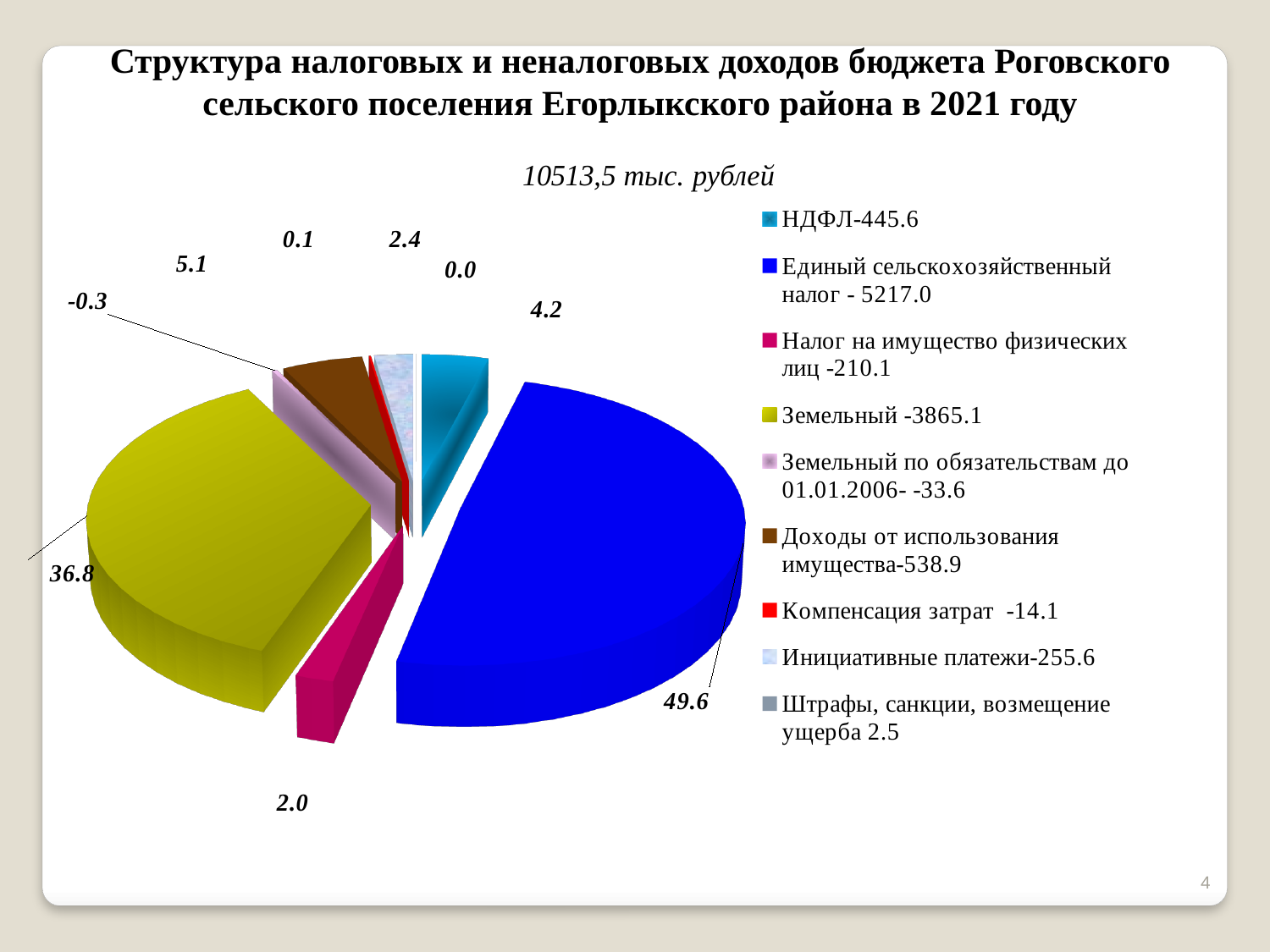
Which has the larger labelled share: НДФЛ or Доходы от использования имущества? Доходы от использования имущества Which category has the largest share of the pie? Единый сельскохозяйственный налог What kind of chart is shown on the slide? pie chart How many entries does the legend of the pie chart list? 9 What total amount in thousand rubles is shown above the pie chart? 10513,5 тыс. рублей What is the difference between the labelled shares of Единый сельскохозяйственный налог (49.6) and Земельный (36.8)? 12.8 What share of the pie is labelled for Единый сельскохозяйственный налог? 49.6 What share of the pie is labelled for Земельный? 36.8 What share of the pie is labelled for НДФЛ? 4.2 What value does the legend give for Доходы от использования имущества? 538.9 How many slices does the pie chart have? 8 What value does the legend give for Инициативные платежи? 255.6